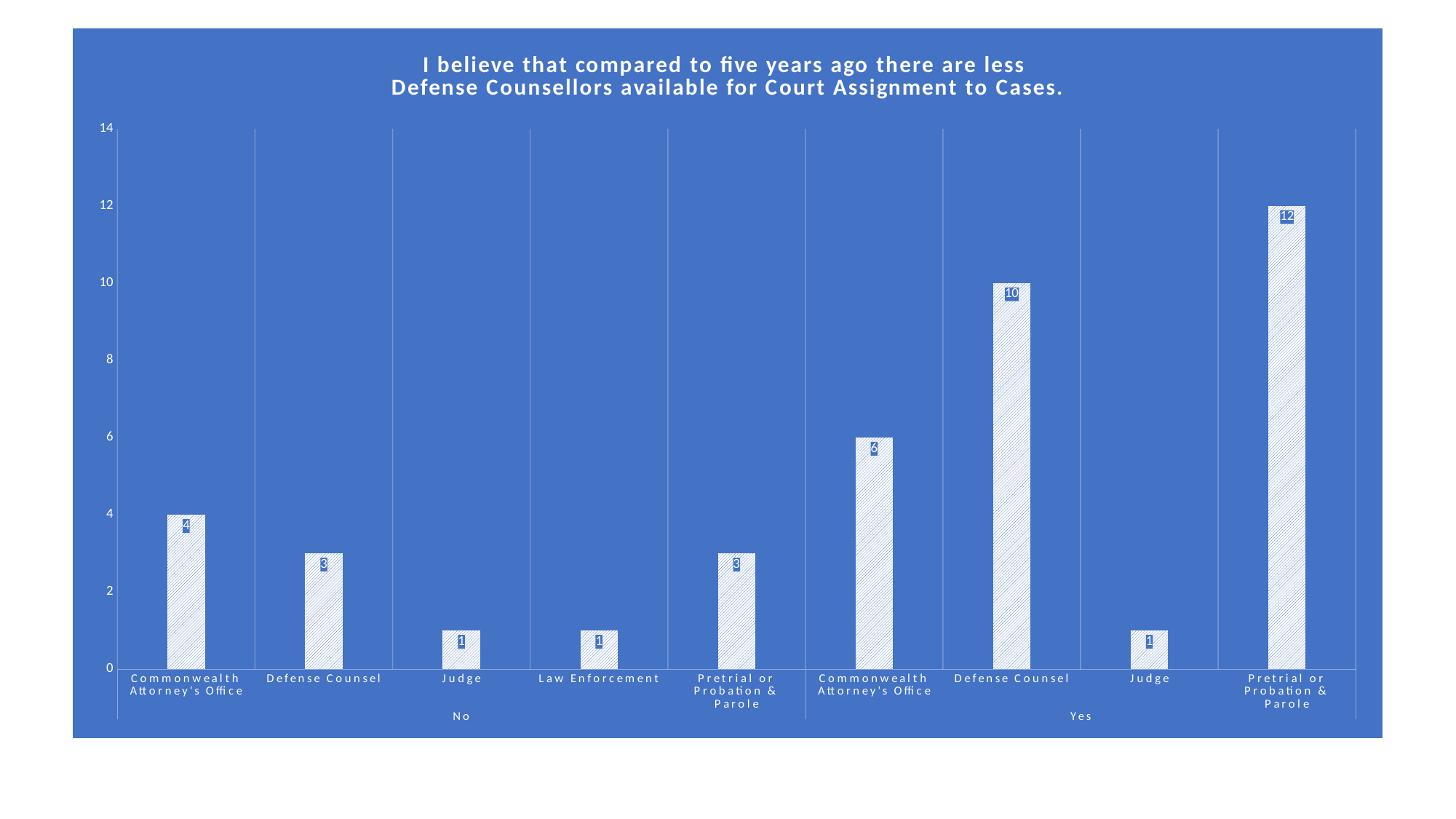
What is the maximum value shown on the vertical axis? 14 What is the value for Judge in the Yes group? 1 What is the difference between the Yes and No values for Defense Counsel? 7 What is the total of the Yes group values? 29 Which category has the highest value on the chart? Pretrial or Probation & Parole (Yes) How many bars are plotted on the chart? 9 What is the value for Defense Counsel in the Yes group? 10 What is the value for Pretrial or Probation & Parole in the Yes group? 12 What is the value for Commonwealth Attorney's Office in the No group? 4 What kind of chart is shown on the slide? Bar chart What is the value for Law Enforcement in the No group? 1 Which is larger: Commonwealth Attorney's Office under Yes or under No? Yes